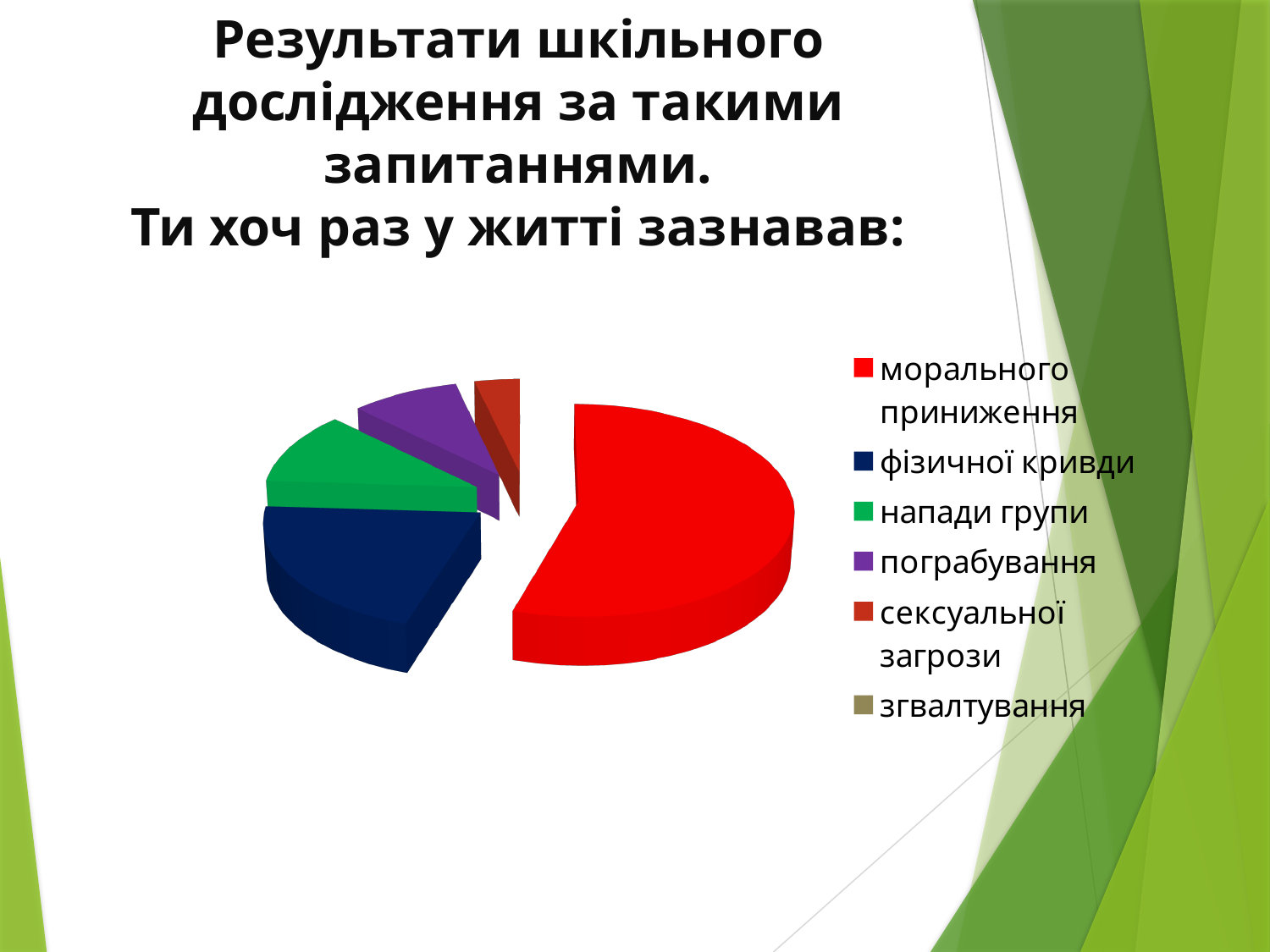
Which legend entry is shown in green? напади групи Which slice is larger: фізичної кривди or пограбування? фізичної кривди How many entries does the chart legend list? 6 What colour is the slice for морального приниження? red Which slice is larger: пограбування or сексуальної загрози? пограбування Which slice is larger: напади групи or сексуальної загрози? напади групи Which category has the largest slice of the pie? морального приниження What kind of chart is shown on the slide? pie chart